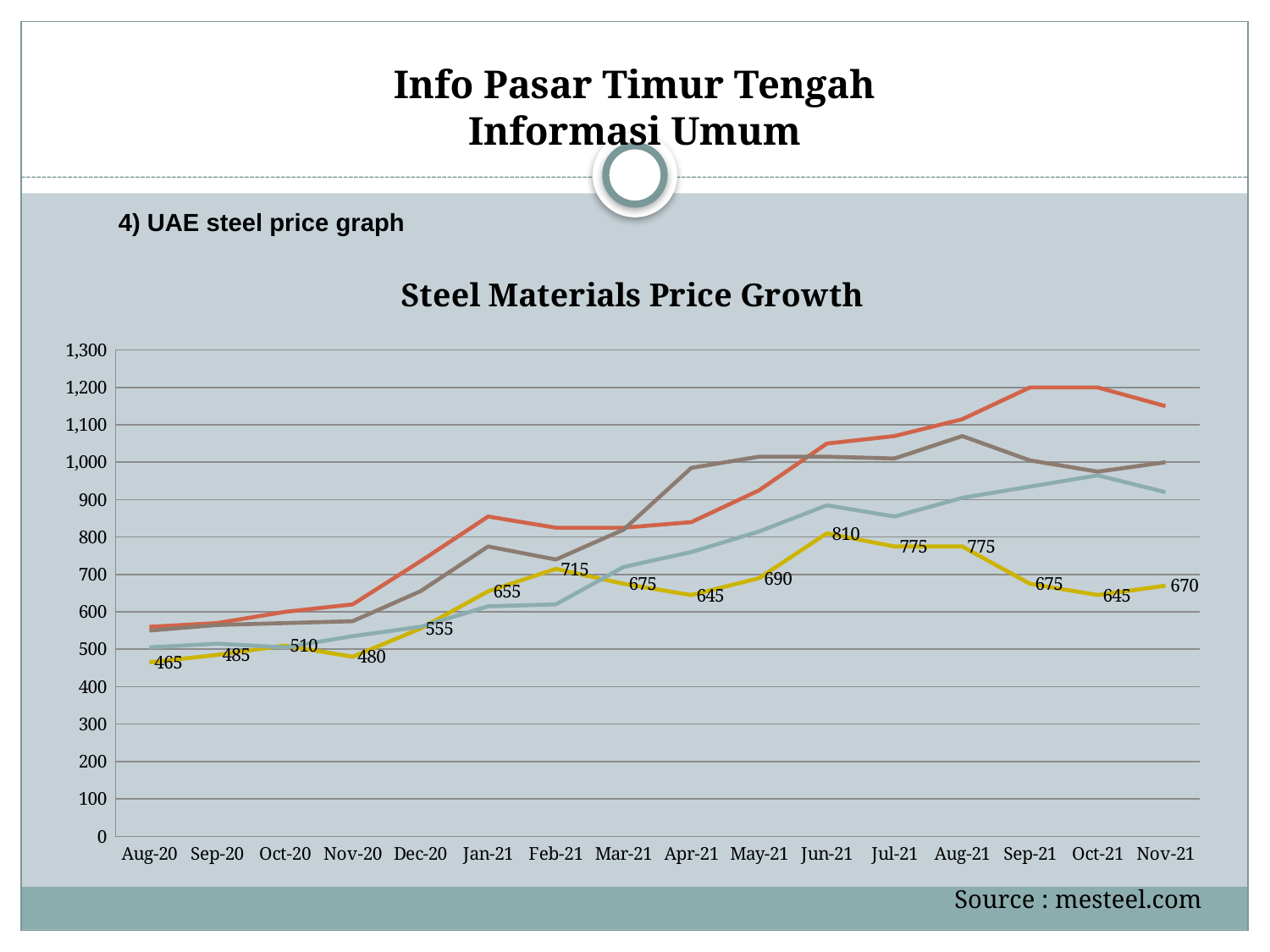
Is the value of the red line for Sep-21 greater or less than 1,100? greater In which month does the yellow line reach its highest value? Jun-21 How many lines are plotted on the chart? 4 In which month does the yellow line have its lowest value? Aug-20 What is the value of the yellow line for Nov-21? 670 What is the difference between the yellow line's highest value (Jun-21) and its lowest value (Aug-20)? 345 What is the title of the chart? Steel Materials Price Growth For the yellow line, which month has the larger value, Jan-21 or Feb-21? Feb-21 What is the value of the yellow line (the line with data labels) for Aug-20? 465 What is the value of the yellow line for Jun-21? 810 What type of chart is shown on the slide? Line chart How many months are shown on the x axis of the chart? 16